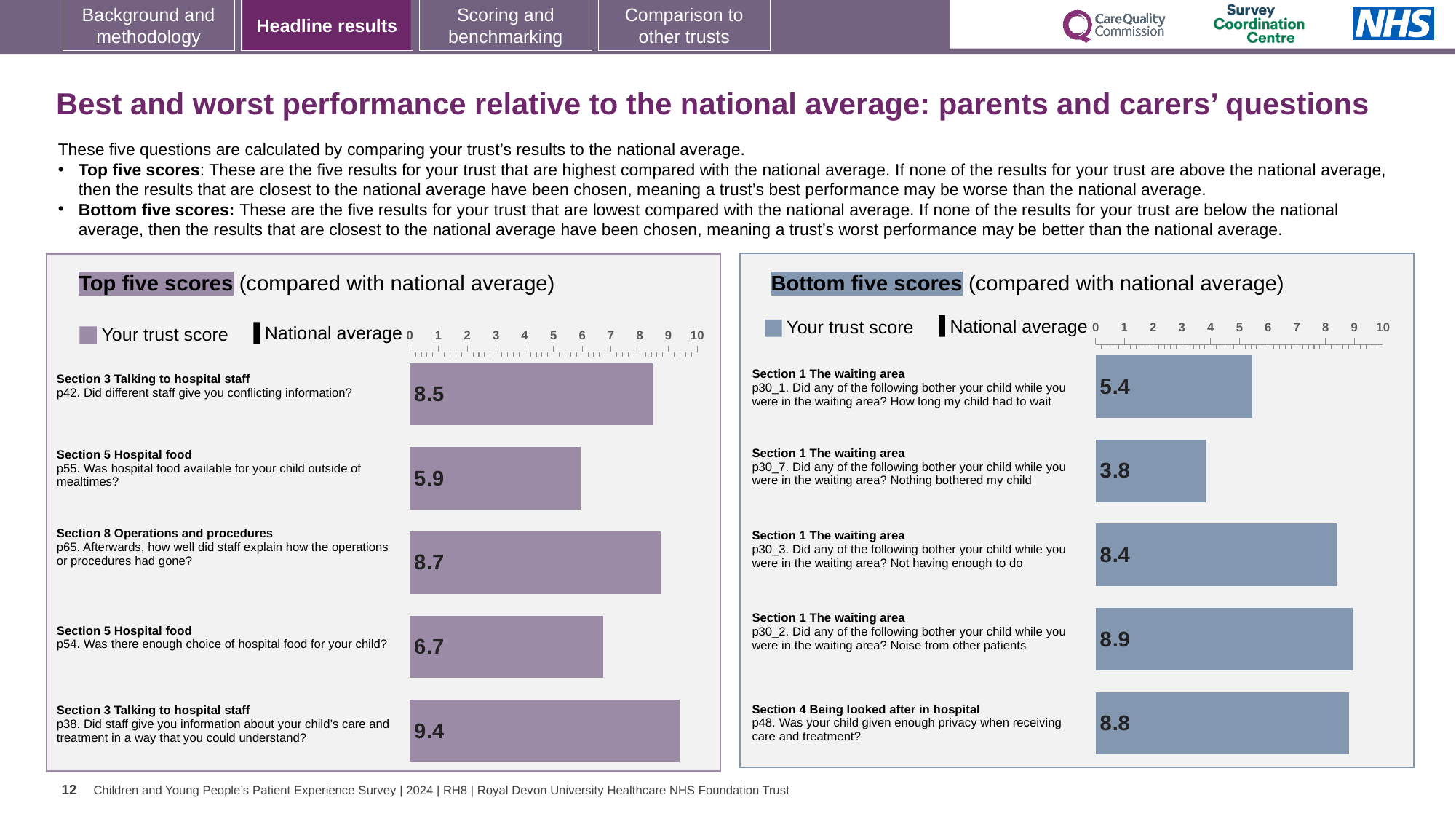
In the Bottom five scores chart, what is the difference between the trust scores for p30_2 'Noise from other patients' and p30_7 'Nothing bothered my child'? 5.1 In the Top five scores chart, what is the trust score for p42 'Did different staff give you conflicting information?' 8.5 In the Top five scores chart, which question has the lowest trust score? p55. Was hospital food available for your child outside of mealtimes? In the Bottom five scores chart, what is the trust score for p30_1 'How long my child had to wait'? 5.4 In the Bottom five scores chart, which question has the lowest trust score? p30_7. Nothing bothered my child In the Top five scores chart, which question has the highest trust score? p38. Did staff give you information about your child's care and treatment in a way that you could understand? In the Top five scores chart, what is the difference between the highest trust score (p38) and the lowest trust score (p55)? 3.5 In the Bottom five scores chart, what is the trust score for p48 'Was your child given enough privacy when receiving care and treatment?' 8.8 In the Bottom five scores chart, which is larger: the trust score for p30_3 'Not having enough to do' or for p30_1 'How long my child had to wait'? p30_3 (8.4) How many series does the legend of the Bottom five scores chart list? 2 How many questions are plotted in the Top five scores chart? 5 In the Top five scores chart, what is the trust score for p54 'Was there enough choice of hospital food for your child?' 6.7